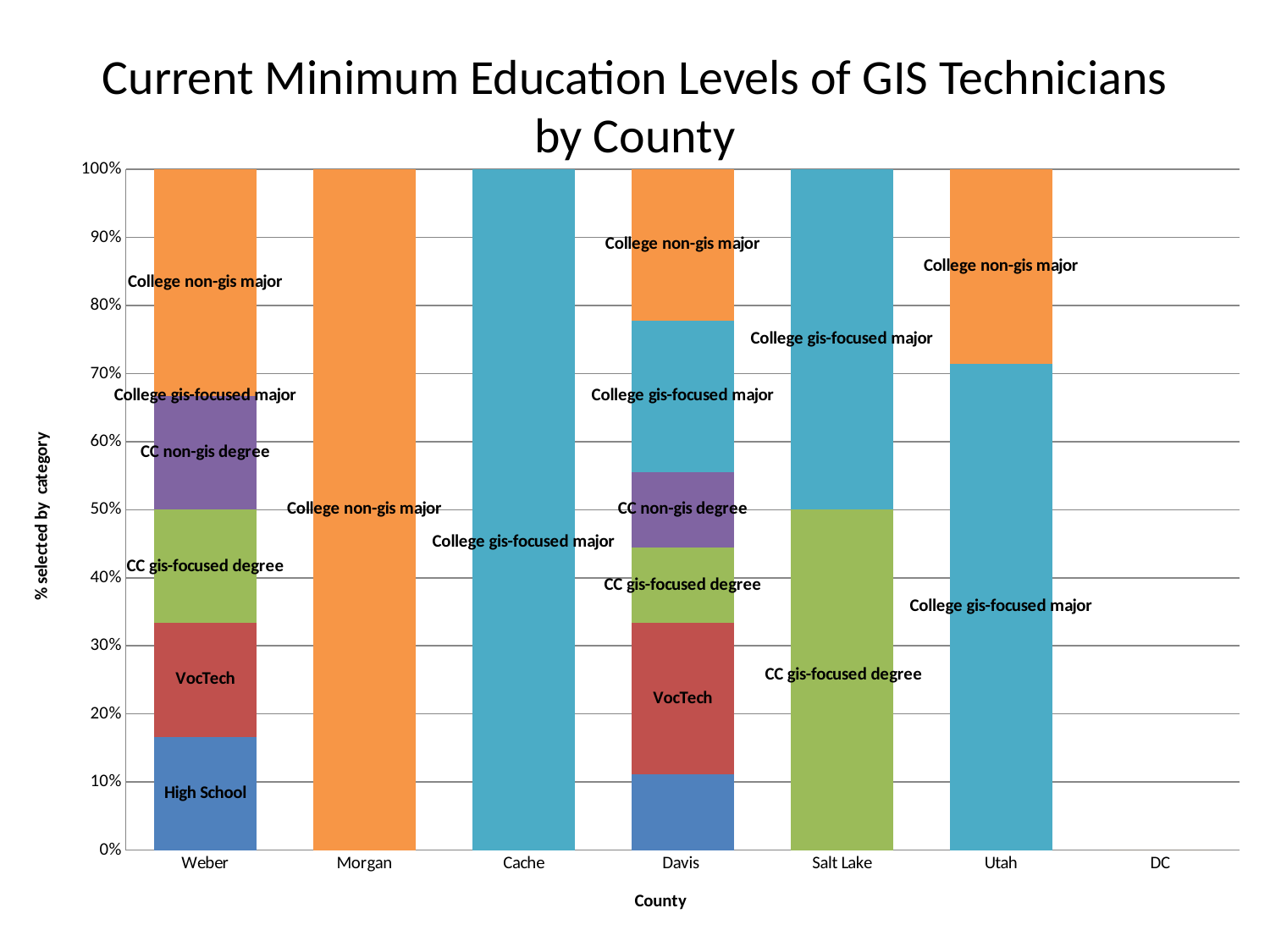
What percentage of the Morgan bar is College non-gis major? 100% What percentage of the Salt Lake bar is CC gis-focused degree? 50% Is the College gis-focused major share for Utah greater or less than 60%? greater Which is larger, the College gis-focused major share for Salt Lake or for Utah? Utah Is the High School share for Weber greater or less than 20%? less What percentage of the Cache bar is College gis-focused major? 100% How many counties are listed along the x axis? 7 Which county has no bar plotted at all? DC What is the label of the y axis? % selected by category What is the title of the chart? Current Minimum Education Levels of GIS Technicians by County What kind of chart is shown on the slide? Stacked bar chart Is the High School share for Davis greater or less than 20%? less